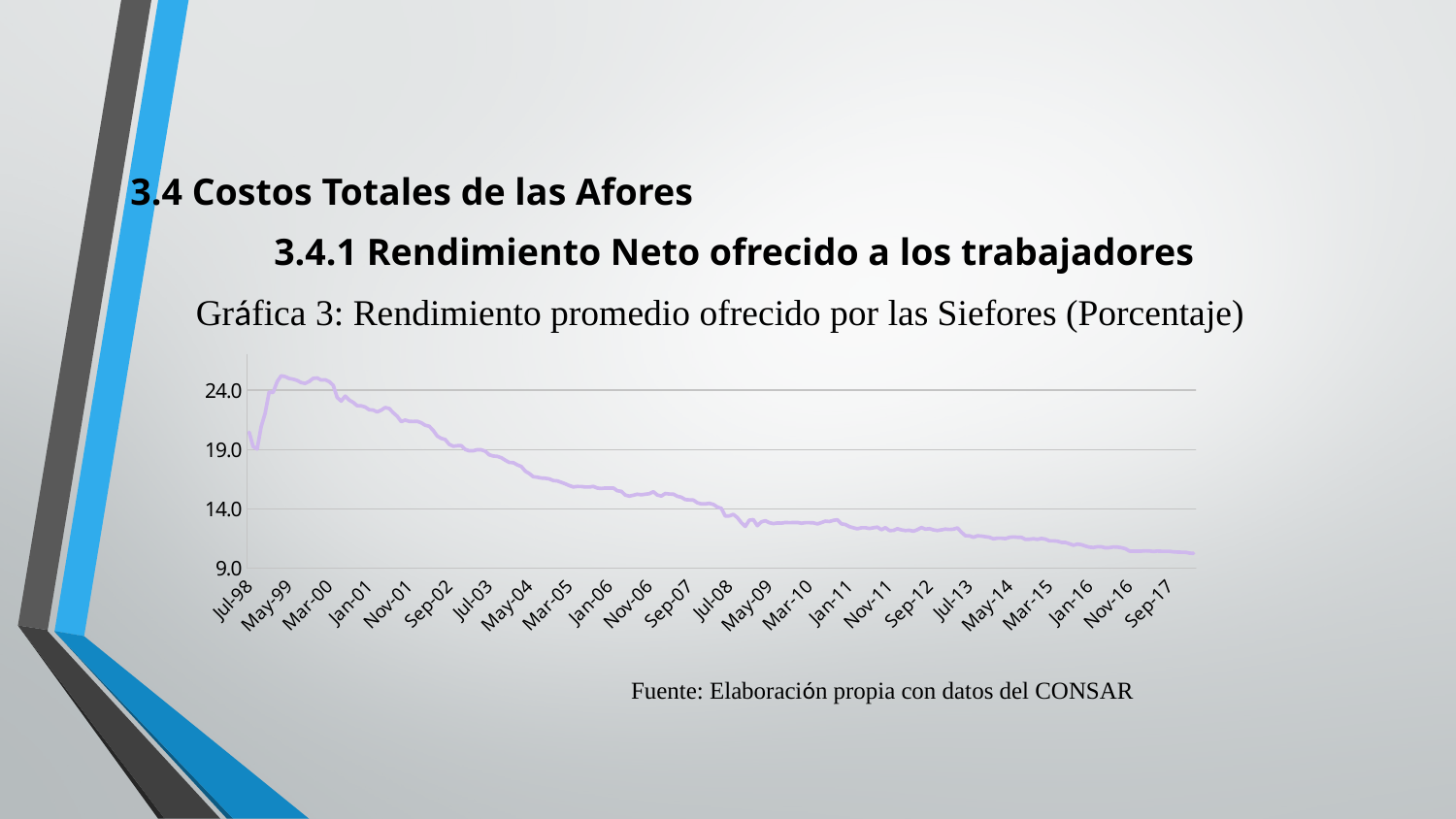
How many date labels are shown on the x axis? 24 Is the value for Mar-00 greater or less than 19.0? greater Which is larger, the value for Sep-02 or the value for Mar-15? Sep-02 What source is cited below the chart? Elaboración propia con datos del CONSAR What kind of chart is shown on the slide? line chart Is the value for Sep-17 greater or less than 14.0? less Is the value for Jul-08 greater or less than 19.0? less Which is larger, the value for Jul-98 or the value for Sep-17? Jul-98 What is the title of the chart on the slide? Gráfica 3: Rendimiento promedio ofrecido por las Siefores (Porcentaje) Overall, do the values rise or fall along the x axis from Jul-98 to Sep-17? fall